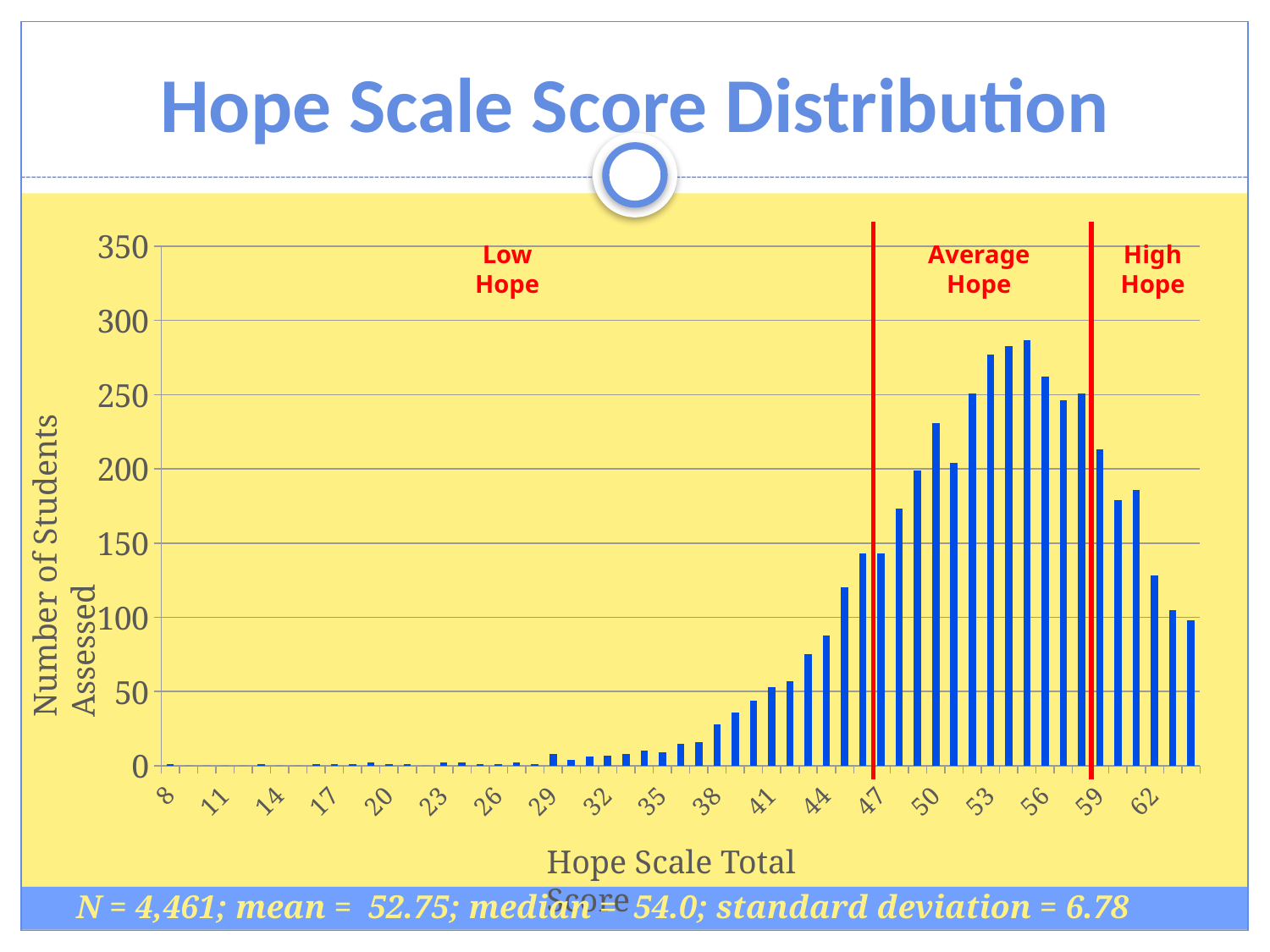
What is the title of the chart? Hope Scale Score Distribution Is the value for score 38 greater or less than 50? less What kind of chart is shown on the slide? bar chart Is the value for score 53 greater or less than 250? greater Is the value for score 44 greater or less than 50? greater Which has more students assessed, score 53 or score 47? 53 Which has more students assessed, score 50 or score 62? 50 Do the values generally rise or fall from score 8 to score 53? rise What is the label of the vertical axis? Number of Students Assessed